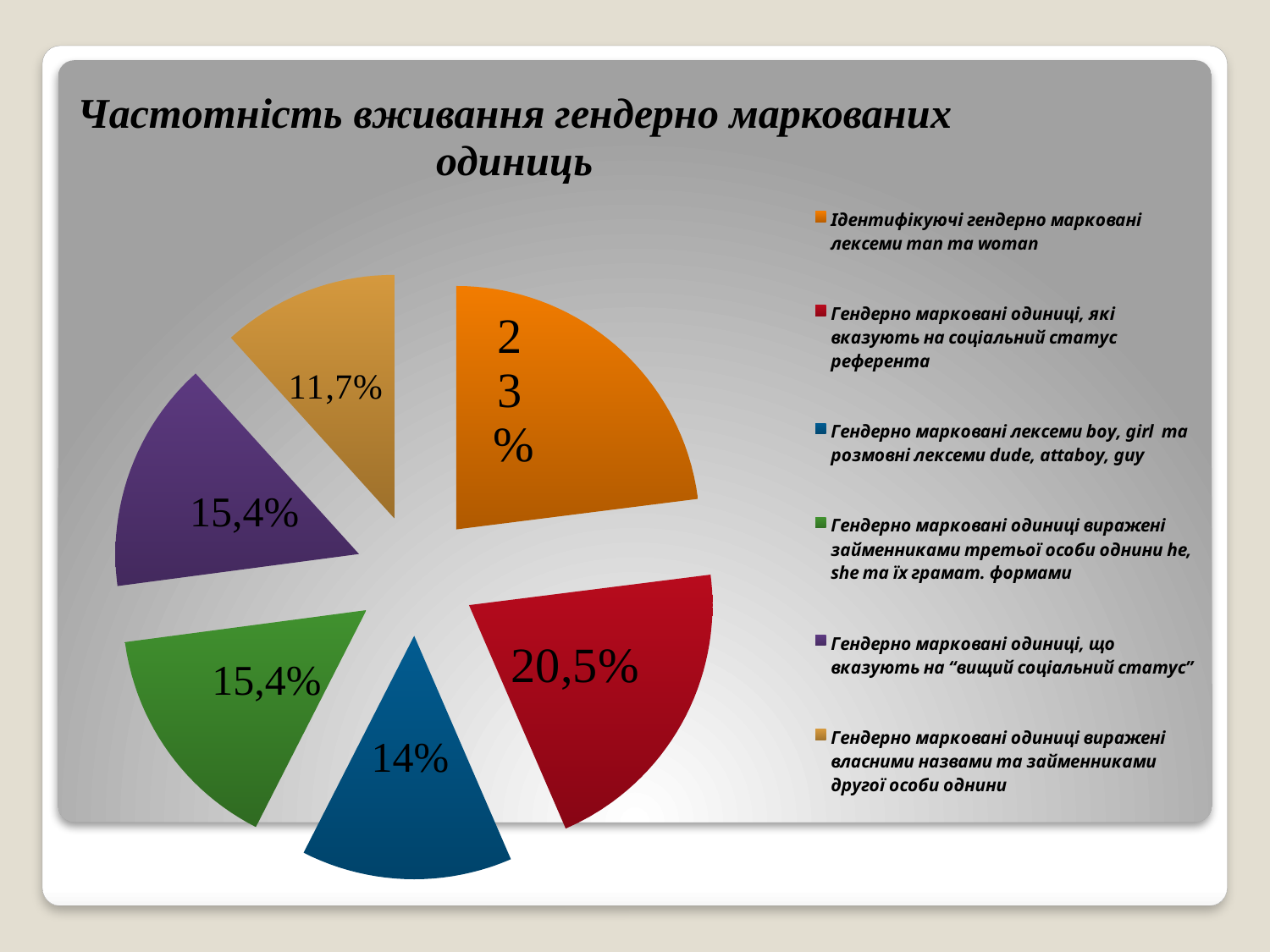
How many entries does the legend of the pie chart list? 6 What kind of chart is shown on the slide? pie chart Which category has the largest slice of the pie chart? Ідентифікуючі гендерно марковані лексеми man та woman What is the difference in percentage points between the largest slice (23%) and the slice for 'Гендерно марковані одиниці, які вказують на соціальний статус референта' (20,5%)? 2,5 How many slices does the pie chart have? 6 What percentage is shown for the slice 'Гендерно марковані лексеми boy, girl та розмовні лексеми dude, attaboy, guy'? 14% Which category has the smallest slice of the pie chart? Гендерно марковані одиниці виражені власними назвами та займенниками другої особи однини What percentage is shown for the slice 'Гендерно марковані одиниці, які вказують на соціальний статус референта'? 20,5% Which is larger: the slice for 'Гендерно марковані лексеми boy, girl та розмовні лексеми dude, attaboy, guy' or the slice for 'Гендерно марковані одиниці виражені займенниками третьої особи однини he, she та їх грамат. формами'? Гендерно марковані одиниці виражені займенниками третьої особи однини he, she та їх грамат. формами What is the title of the chart on the slide? Частотність вживання гендерно маркованих одиниць What share of the pie does the slice 'Гендерно марковані одиниці, що вказують на "вищий соціальний статус"' represent? 15,4% What percentage is shown for the slice 'Ідентифікуючі гендерно марковані лексеми man та woman'? 23%